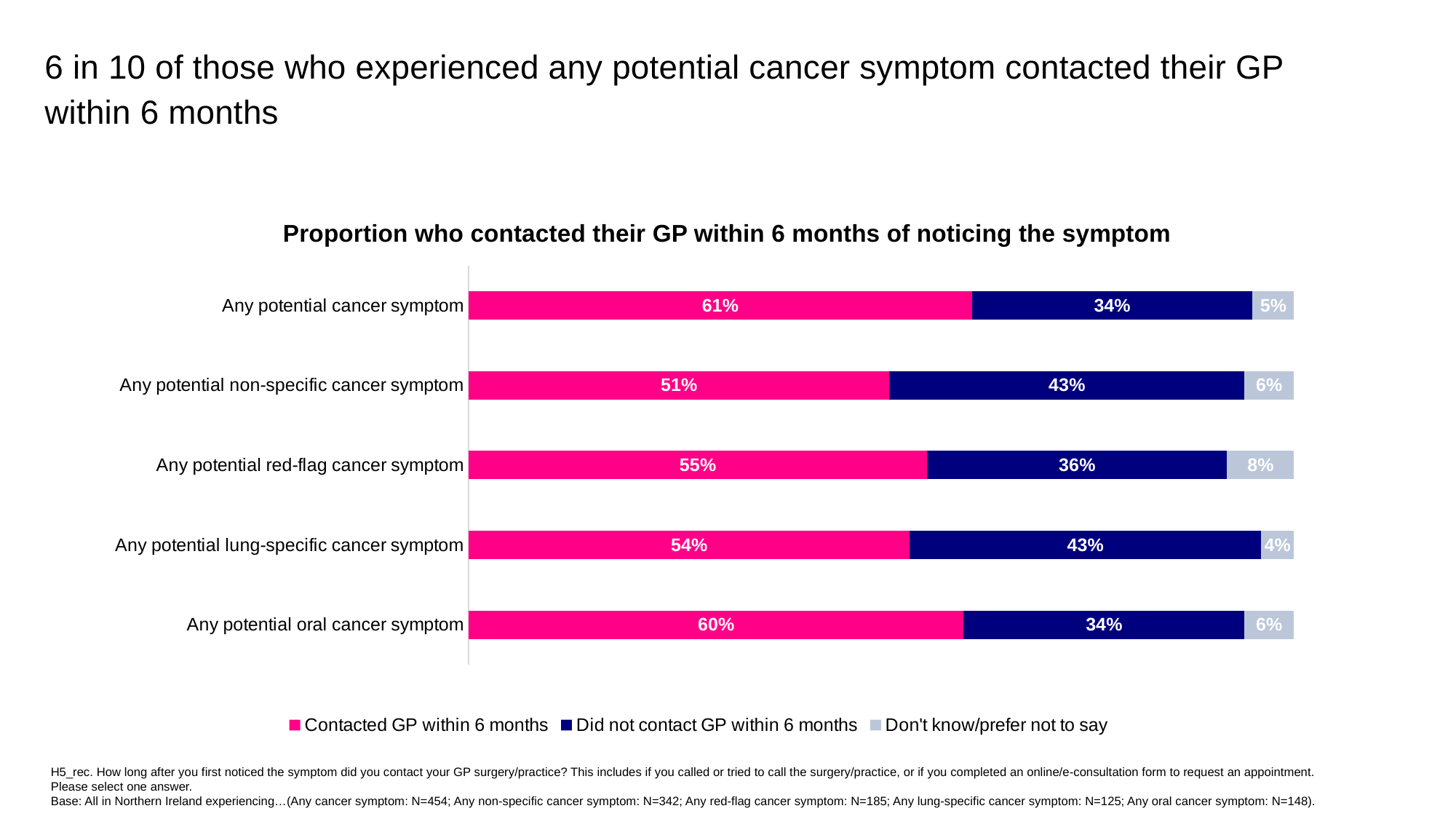
Which is larger: the 'Did not contact GP within 6 months' value for any potential red-flag cancer symptom or for any potential lung-specific cancer symptom? Any potential lung-specific cancer symptom How many symptom categories are shown in the chart? 5 What is the 'Don't know/prefer not to say' value for any potential red-flag cancer symptom? 8% How many series does the legend list? 3 What is the total of the three segments for the any potential oral cancer symptom bar? 100% What is the difference between the 'Contacted GP within 6 months' values for any potential cancer symptom and any potential non-specific cancer symptom? 10 percentage points What is the title of the chart? Proportion who contacted their GP within 6 months of noticing the symptom What kind of chart is shown on the slide? Stacked bar chart Which symptom category has the lowest proportion who contacted their GP within 6 months? Any potential non-specific cancer symptom Which symptom category has the highest proportion who contacted their GP within 6 months? Any potential cancer symptom What percentage of those with any potential non-specific cancer symptom did not contact their GP within 6 months? 43% What percentage of those with any potential cancer symptom contacted their GP within 6 months? 61%